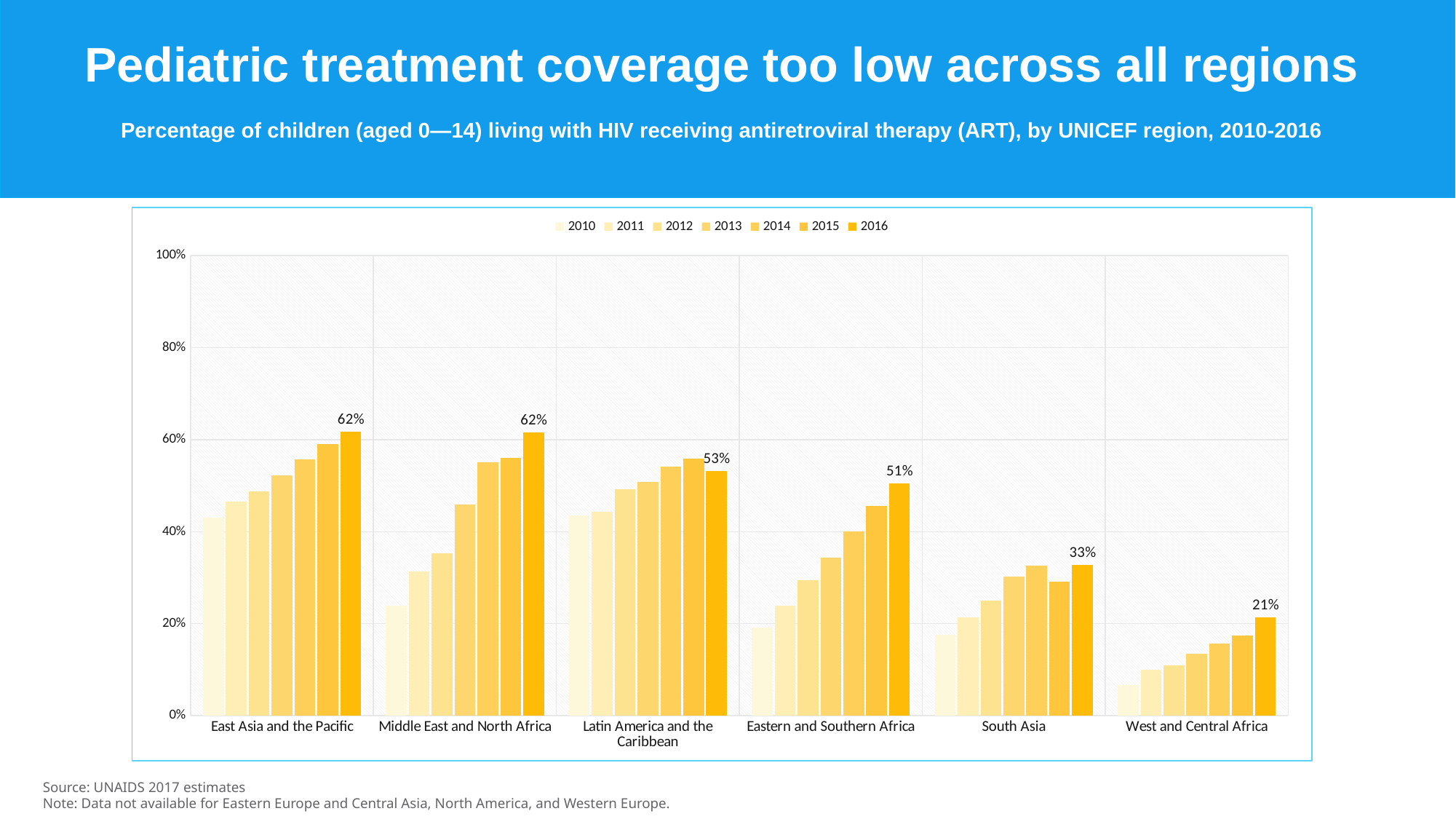
What is the 2016 value for West and Central Africa? 21% How many regions are shown on the x axis? 6 What is the 2016 value for Eastern and Southern Africa? 51% How many series does the legend list? 7 Which is larger, the 2016 value for Eastern and Southern Africa or for South Asia? Eastern and Southern Africa Which region has the lowest 2016 value? West and Central Africa What is the difference between the 2016 values for Latin America and the Caribbean and West and Central Africa? 32% What is the 2016 value for South Asia? 33% Is the 2010 value for East Asia and the Pacific greater or less than 40%? greater Is the 2010 value for West and Central Africa greater or less than 20%? less What is the 2016 value for East Asia and the Pacific? 62% What kind of chart is shown? bar chart